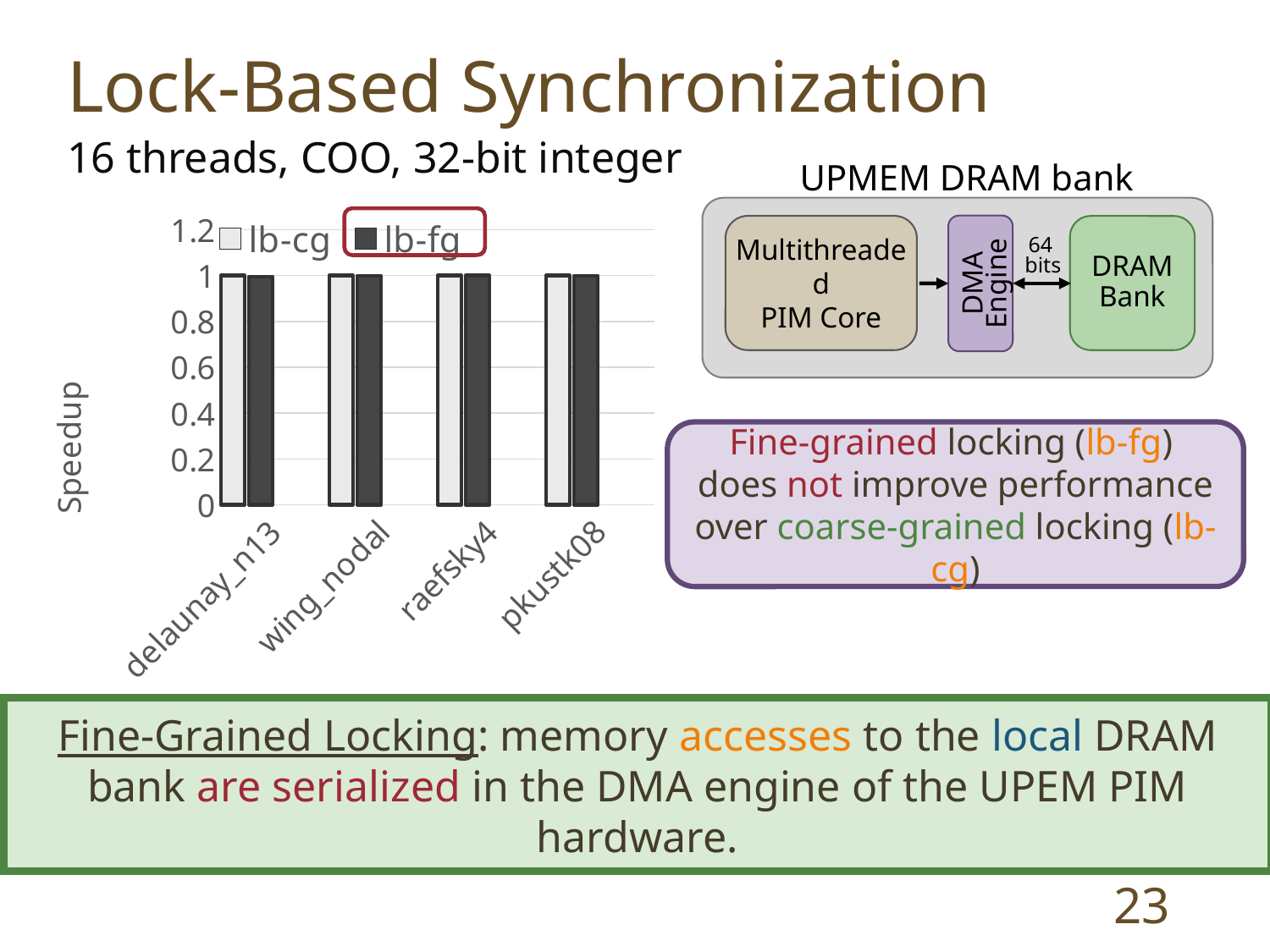
Is the speedup value for lb-fg on delaunay_n13 greater or less than 1.2? less What is the speedup value for lb-cg on delaunay_n13? 1 How many categories are shown on the x axis of the chart? 4 Is the speedup value for lb-cg on wing_nodal greater or less than 0.8? greater What is the speedup value for lb-fg on raefsky4? 1 What is the label of the chart's y axis? Speedup Do the lb-fg speedup values rise, fall, or stay flat across the categories on the x axis? stay flat How many series does the chart's legend list? 2 What are the two series listed in the chart's legend? lb-cg and lb-fg Which category is listed first on the x axis of the chart? delaunay_n13 What is the speedup value for lb-fg on pkustk08? 1 What kind of chart is shown on the slide? bar chart